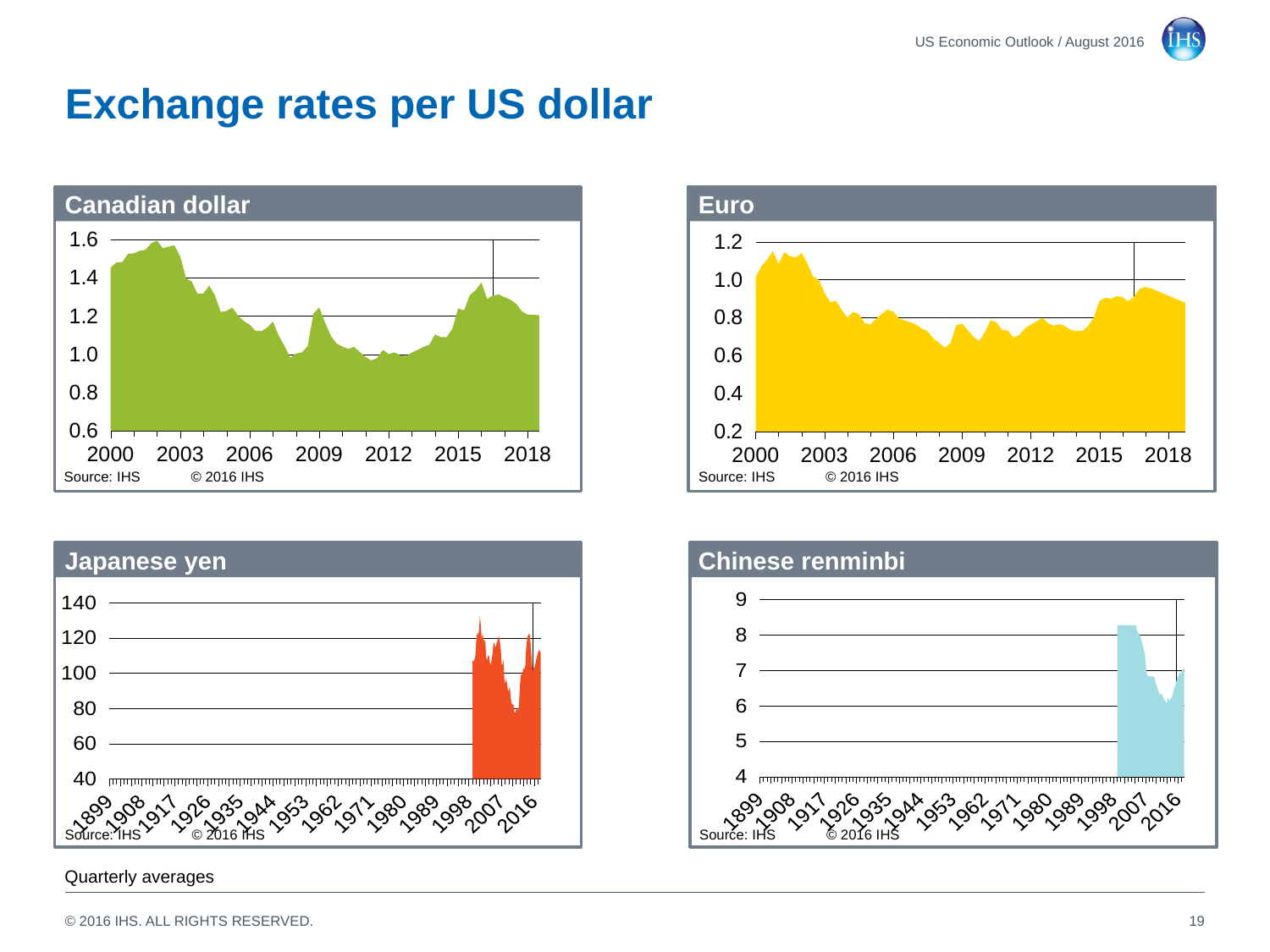
In the Canadian dollar chart, is the value around 2011 greater or less than 1.2? less In the Japanese yen chart, is the value around 2012 greater or less than 100? less What is the title of the chart in the bottom-right position of the slide? Chinese renminbi How many charts are shown on the slide? 4 In the Euro chart, is the value in 2000 greater or less than 0.8? greater In the Canadian dollar chart, does the value rise or fall between 2002 and 2011? fall What kind of chart is the Canadian dollar chart? Area chart In the Euro chart, does the value rise or fall between 2014 and 2016? rise